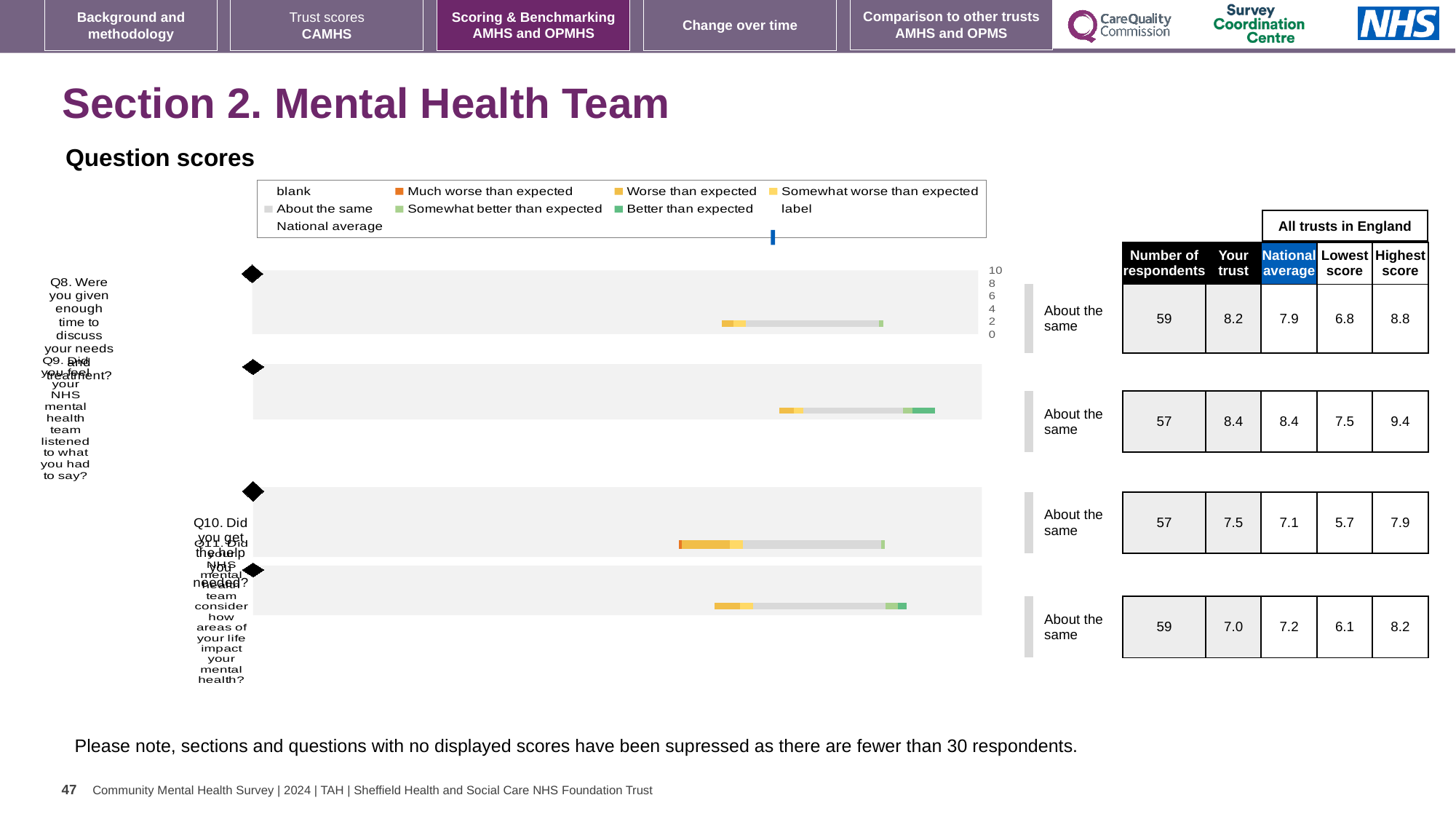
What benchmark label is shown next to the bar for Q8 in the 'Question scores' chart? About the same How many questions (categories) are plotted in the 'Question scores' chart? 4 What benchmark label is shown next to the bar for Q11 in the 'Question scores' chart? About the same What kind of chart is shown under the heading 'Question scores'? bar chart In the 'Question scores' chart legend, what colour represents 'Much worse than expected'? orange In the table beside the 'Question scores' chart, what is the difference between the highest score and lowest score for Q10? 2.2 In the table beside the 'Question scores' chart, which question has the lowest 'Your trust' score? Q11 In the table beside the 'Question scores' chart, is the 'Your trust' score for Q11 larger or smaller than the national average for Q11? smaller In the table beside the 'Question scores' chart, what is the national average for Q9? 8.4 In the table beside the 'Question scores' chart, which question has the highest 'Your trust' score? Q9 In the table beside the 'Question scores' chart, what is the 'Your trust' score for Q8? 8.2 Which question labels appear on the 'Question scores' chart? Q8, Q9, Q10, Q11